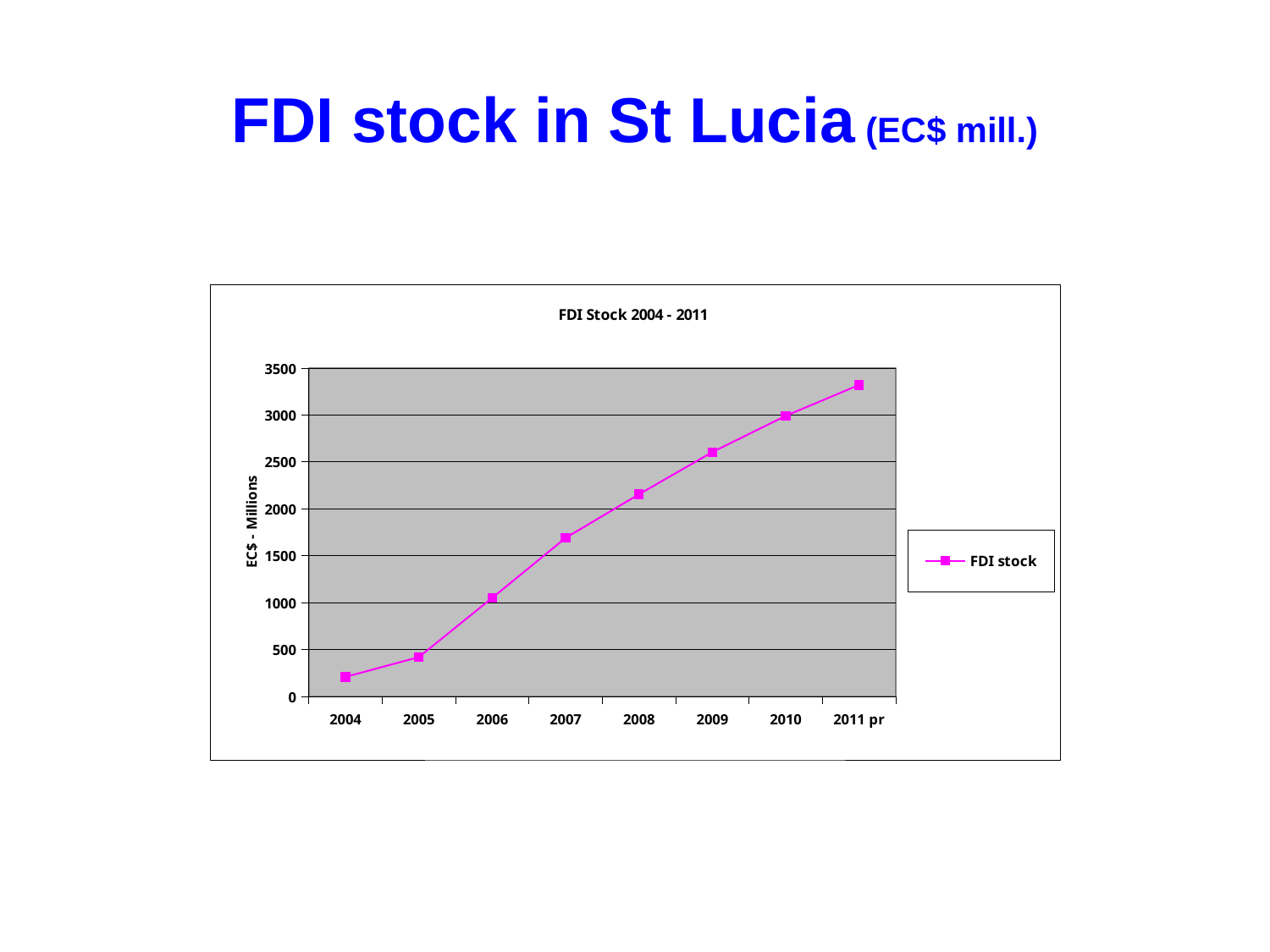
What kind of chart is shown on the slide? line chart Which year has the lowest FDI stock? 2004 Is the value for 2004 greater or less than 500? less Which year has the highest FDI stock? 2011 pr How many series does the legend list? 1 Is the value for 2007 greater or less than 1500? greater Is the value for 2011 pr greater or less than 3000? greater What is the label on the y axis? EC$ - Millions How many years are plotted on the x axis? 8 Does the FDI stock rise or fall from 2004 to 2011 pr? rise What is the title of the chart? FDI Stock 2004 - 2011